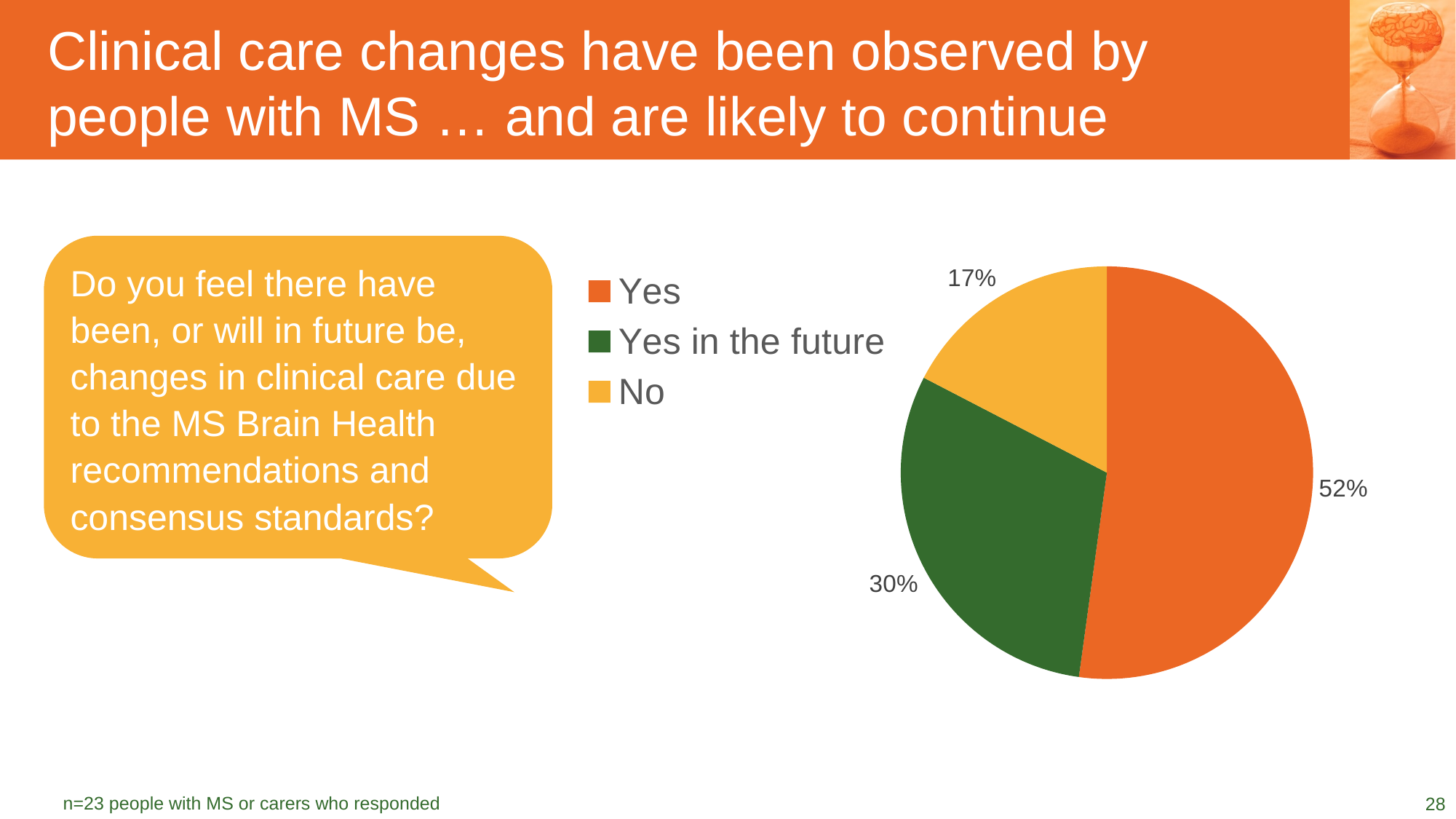
What colour is the "Yes in the future" slice? green What is the difference in percentage points between "Yes" and "No"? 35 Which response has the largest share of the pie? Yes What percentage of respondents answered "Yes"? 52% What kind of chart is shown on the slide? pie chart What percentage of respondents answered "No"? 17% How many slices does the pie chart have? 3 Which is larger, the share for "Yes in the future" or the share for "No"? Yes in the future What percentage of respondents answered "Yes in the future"? 30% How many entries does the legend list? 3 Which response has the smallest share of the pie? No What is the difference in percentage points between "Yes" and "Yes in the future"? 22